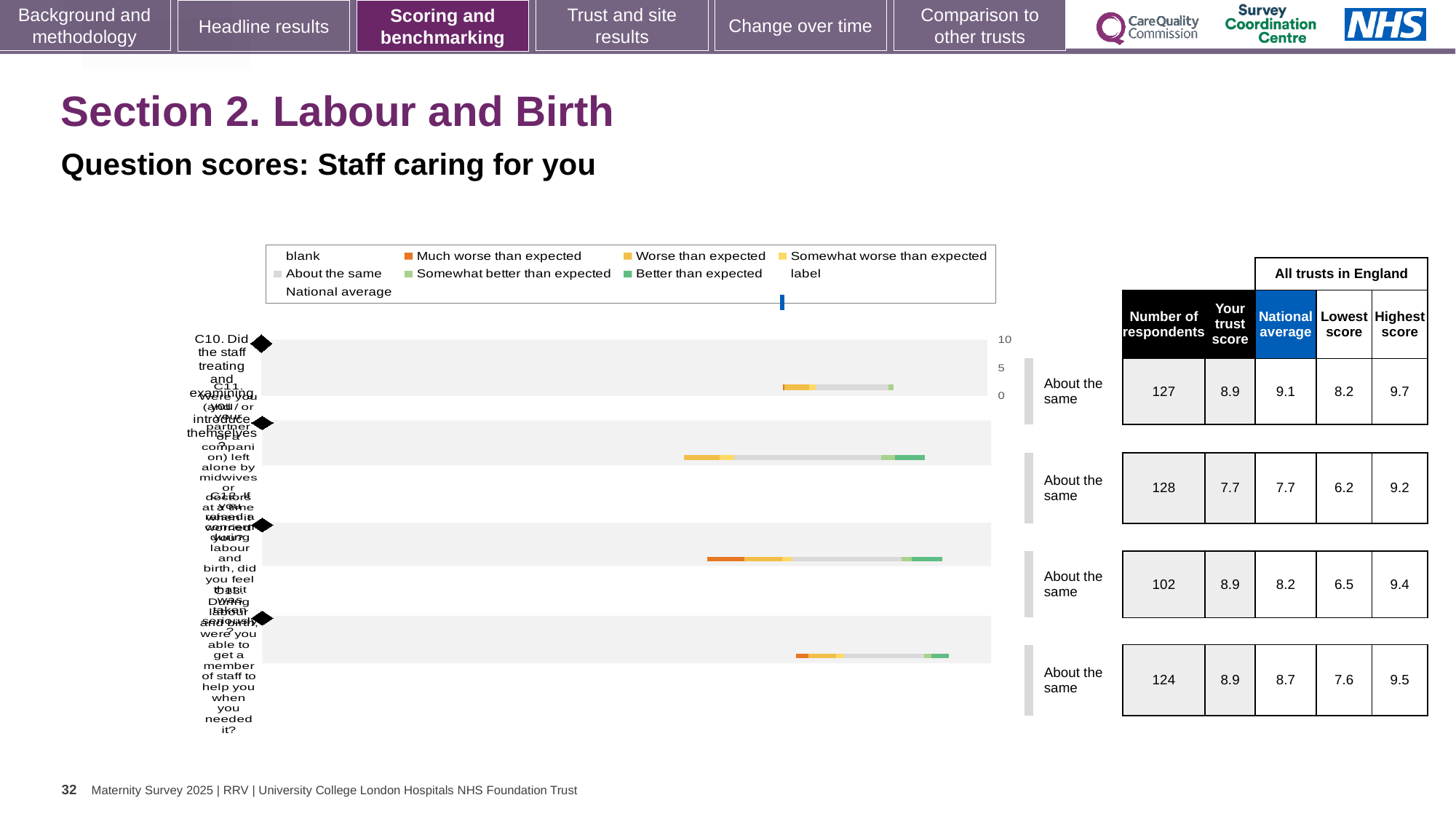
In the table beside the chart, what is the highest score for the fourth (bottom) question bar? 9.5 Which legend entry is shown in orange in the chart legend? Much worse than expected What is the difference between the highest score and the lowest score for the second question bar in the table? 3.0 In the table beside the chart, what is the number of respondents for the first (top) question bar? 127 In the table beside the chart, what is the national average for the second question bar? 7.7 In the table beside the chart, what is the lowest score for the third question bar? 6.5 Which legend entry is shown in grey in the chart legend? About the same What benchmark category is shown next to every question bar? About the same Which question bar has the lowest number of respondents in the table beside the chart? the third bar (102) How many question bars are plotted in the chart? 4 What kind of chart is shown on the slide? bar chart For the first question bar, is the national average (9.1) larger or smaller than your trust score (8.9)? larger